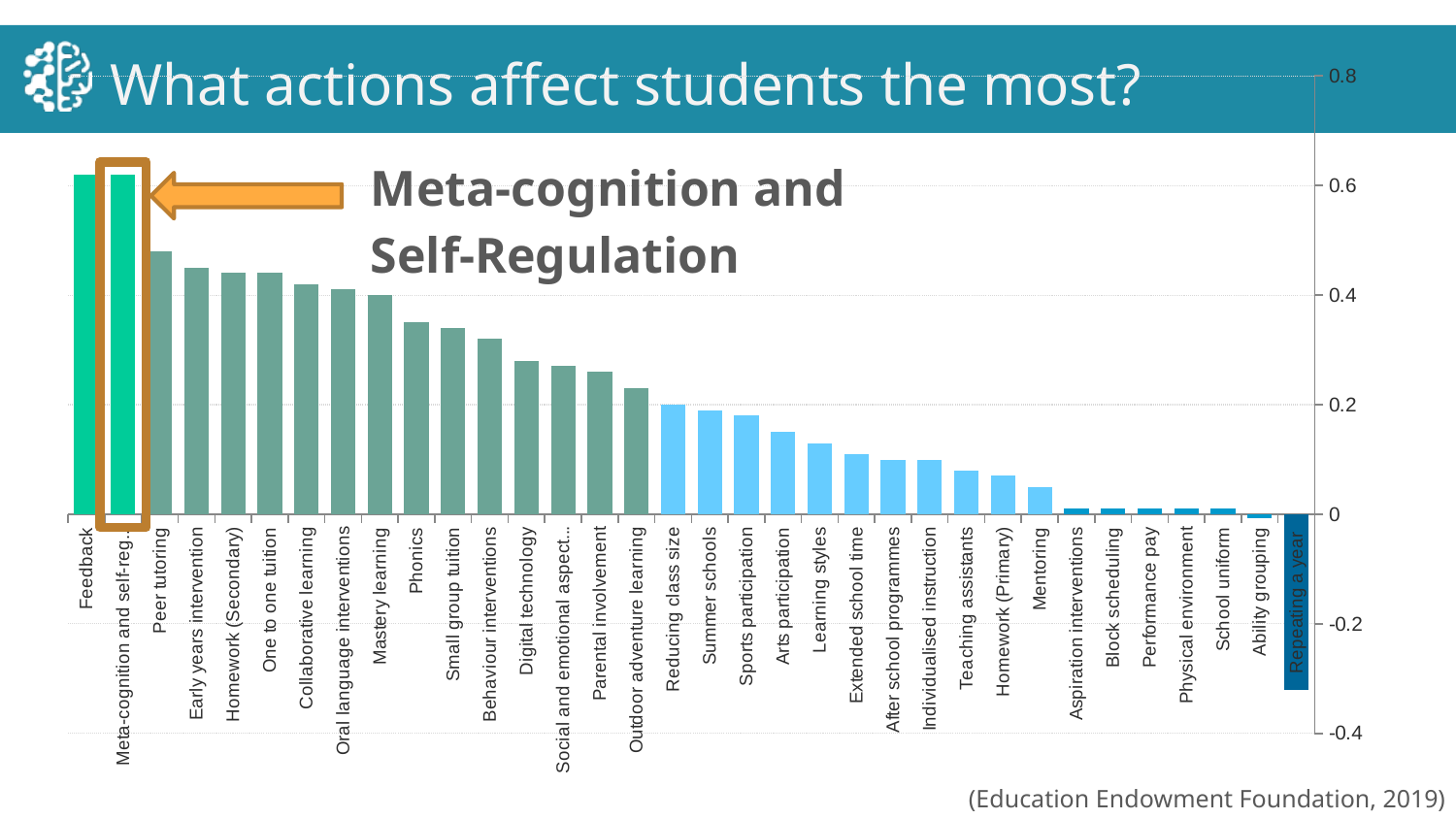
Is the value for Mentoring greater or less than 0.2? less Is the value for Peer tutoring greater or less than 0.4? greater What kind of chart is shown on the slide? bar chart Is the value for Phonics greater or less than 0.4? less How many categories (actions) are plotted on the chart? 34 What is the title of the slide containing the chart? What actions affect students the most? Which has the larger value, Peer tutoring or Phonics? Peer tutoring Which has the larger value, Summer schools or Mentoring? Summer schools Do the values rise or fall moving from left to right along the x axis? fall Which action has the lowest value on the chart? Repeating a year